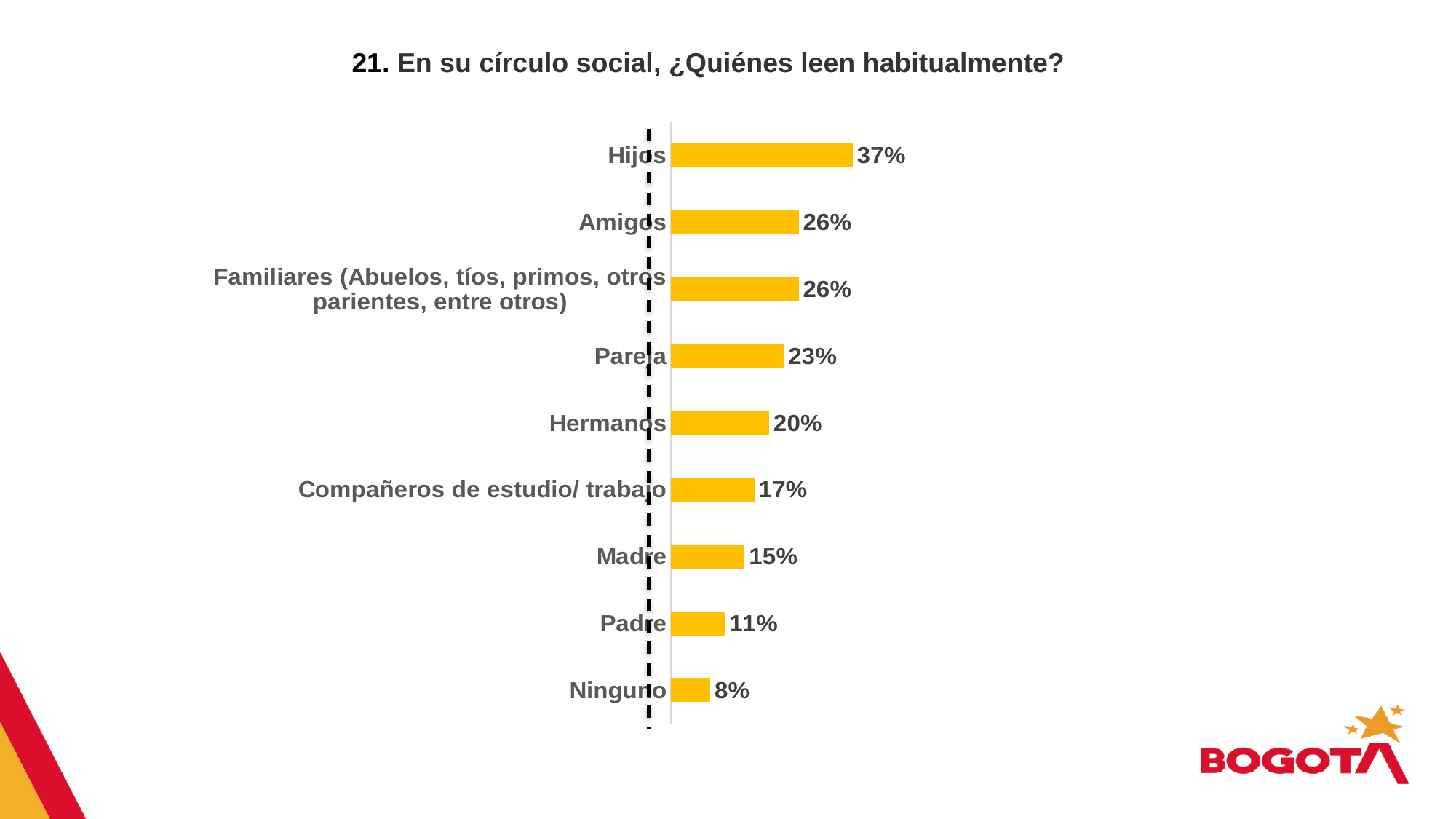
What is the difference between the values for Hijos and Amigos? 11% What is the title of the chart? 21. En su círculo social, ¿Quiénes leen habitualmente? Which category has the lowest value? Ninguno What is the value for Pareja? 23% What is the value for Compañeros de estudio/ trabajo? 17% Which is larger, the value for Hermanos or the value for Madre? Hermanos What is the difference between the values for Madre and Padre? 4% What is the value for Ninguno? 8% What is the value for Hijos? 37% Which category has the highest value? Hijos How many categories are shown in the chart? 9 What kind of chart is shown on the slide? Bar chart